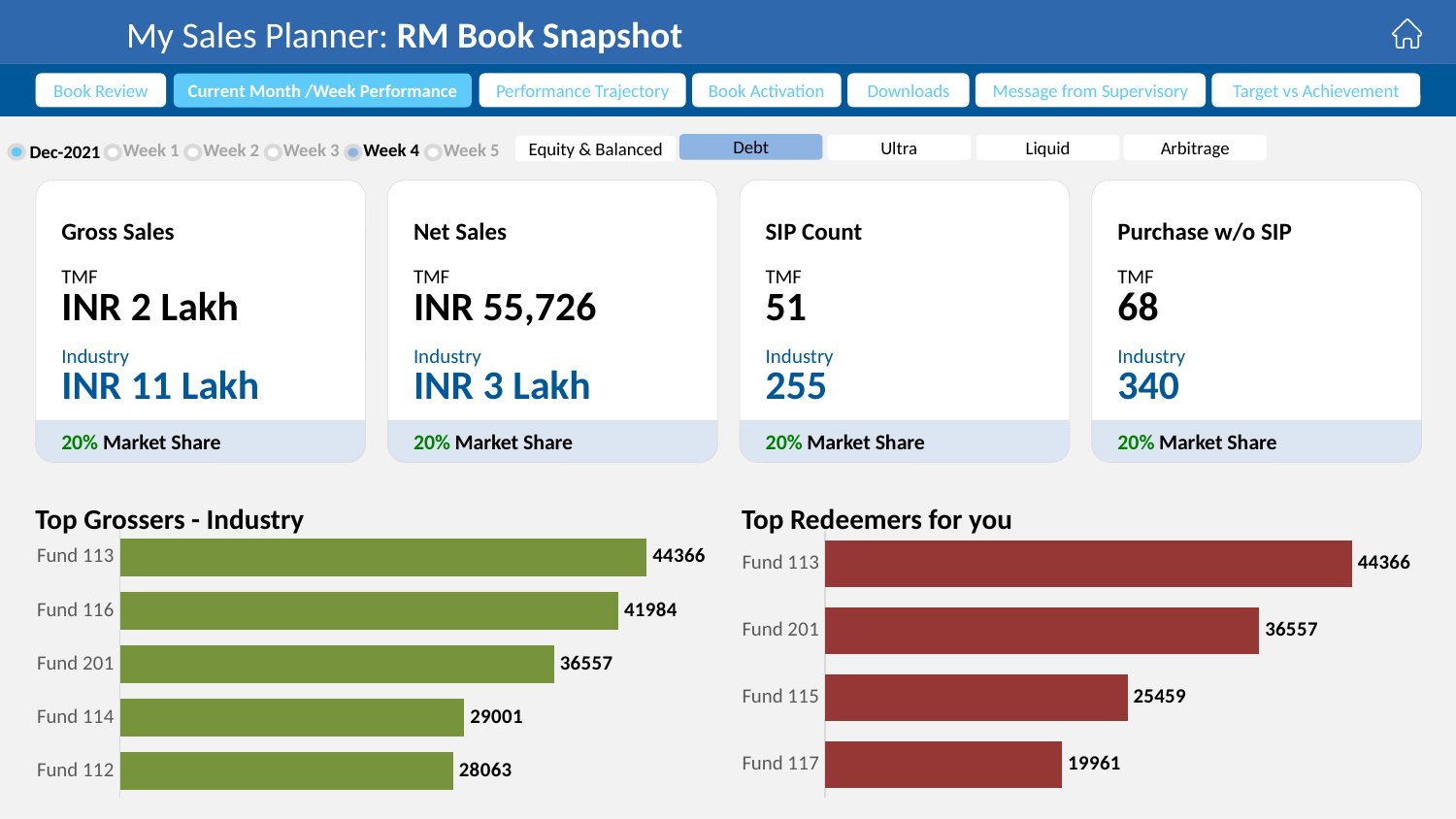
In the 'Top Grossers - Industry' chart, which fund has the lowest value? Fund 112 In the 'Top Grossers - Industry' chart, which fund has the highest value? Fund 113 In the 'Top Redeemers for you' chart, which fund has the lowest value? Fund 117 In the 'Top Redeemers for you' chart, how many funds are shown? 4 In the 'Top Grossers - Industry' chart, what is the value for Fund 116? 41984 In the 'Top Redeemers for you' chart, what is the difference between the values for Fund 201 and Fund 117? 16596 What colour are the bars in the 'Top Redeemers for you' chart? Red In the 'Top Redeemers for you' chart, what is the value for Fund 115? 25459 In the 'Top Grossers - Industry' chart, what is the difference between the values for Fund 113 and Fund 112? 16303 What kind of chart is 'Top Grossers - Industry'? Bar chart In the 'Top Grossers - Industry' chart, how many funds are shown? 5 In the 'Top Redeemers for you' chart, which is larger, the value for Fund 201 or Fund 115? Fund 201